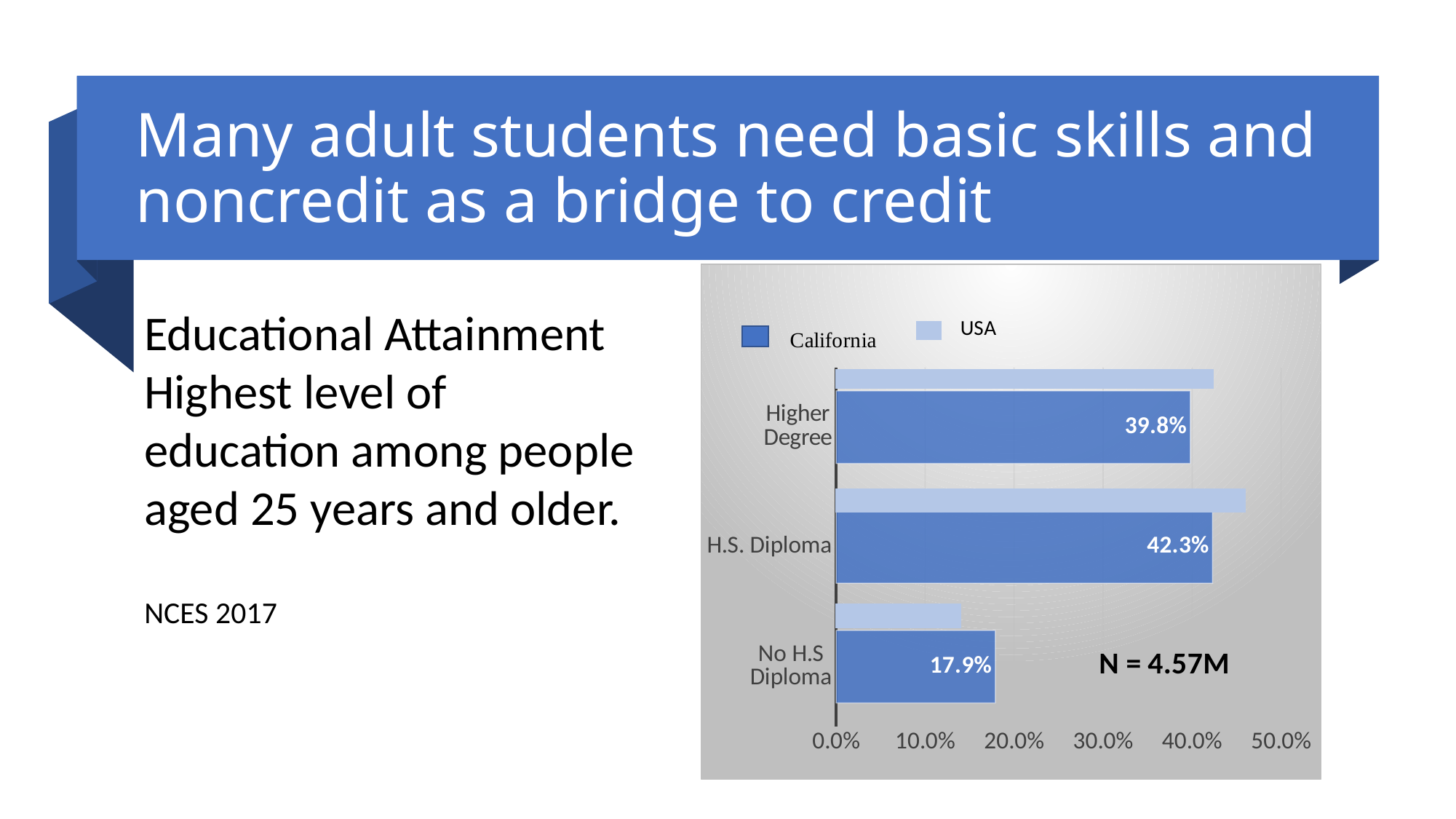
How many series does the legend list? 2 Which category has the lowest California value? No H.S Diploma What is the difference between the California values for H.S. Diploma and No H.S Diploma? 24.4 percentage points What is the California value for H.S. Diploma? 42.3% For H.S. Diploma, which is larger, the California value or the USA value? USA For No H.S Diploma, which is larger, the California value or the USA value? California What is the California value for No H.S Diploma? 17.9% What is the California value for Higher Degree? 39.8% Which category has the highest California value? H.S. Diploma Is the USA value for No H.S Diploma greater or less than 20%? less What is the difference between the California values for H.S. Diploma and Higher Degree? 2.5 percentage points Is the USA value for H.S. Diploma greater or less than 40%? greater